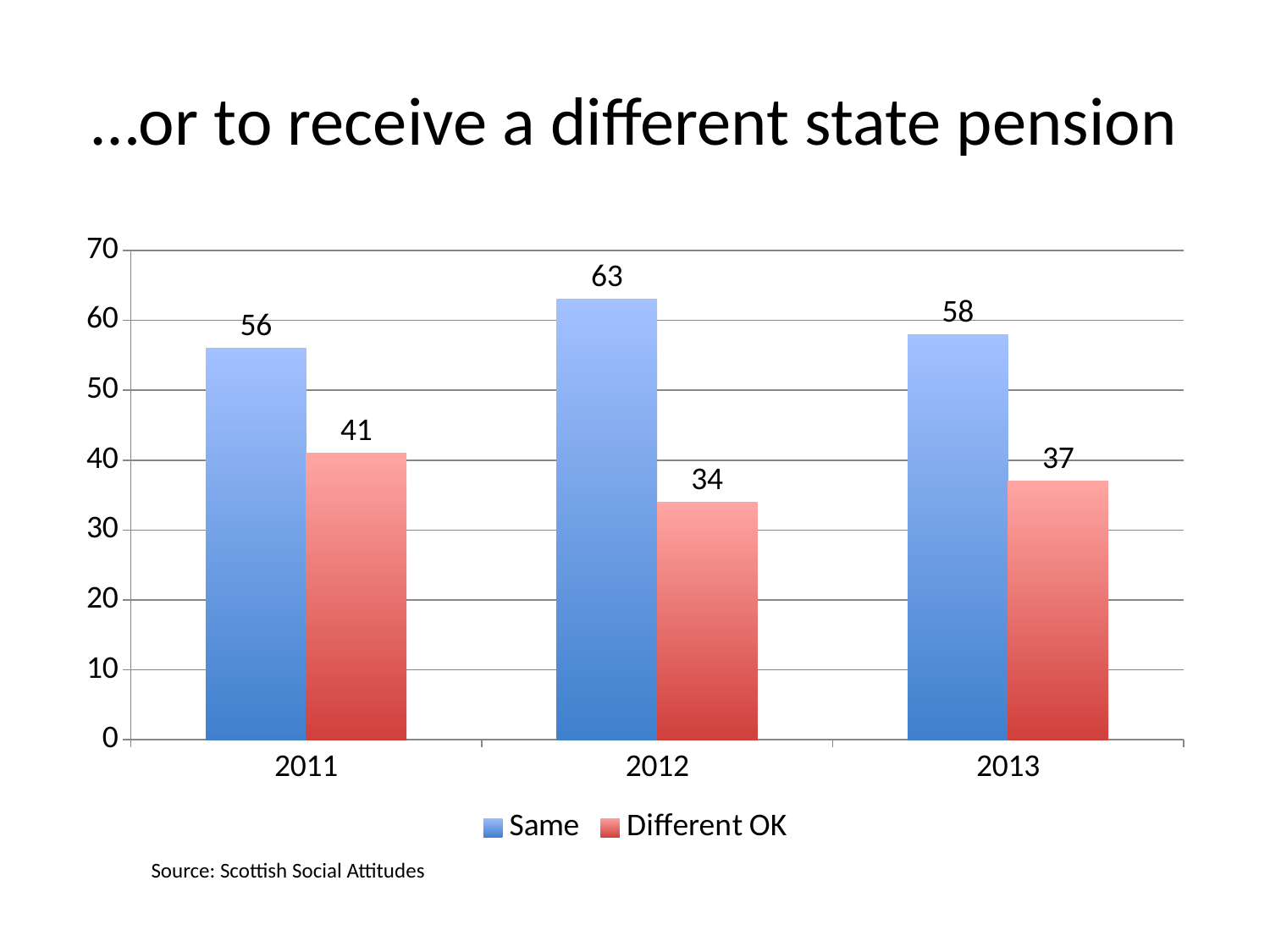
What is the value for Different OK in 2013? 37 What is the value for Different OK in 2011? 41 What is the value for Same in 2012? 63 What kind of chart is shown on the slide? Bar chart In which year is the Different OK series lowest? 2012 In which year is the Same series highest? 2012 What is the difference between Same and Different OK in 2012? 29 What source is cited below the chart? Scottish Social Attitudes What is the difference between the Same values for 2012 and 2013? 5 How many years are shown on the x axis? 3 Which is larger in 2011, Same or Different OK? Same How many series does the legend list? 2